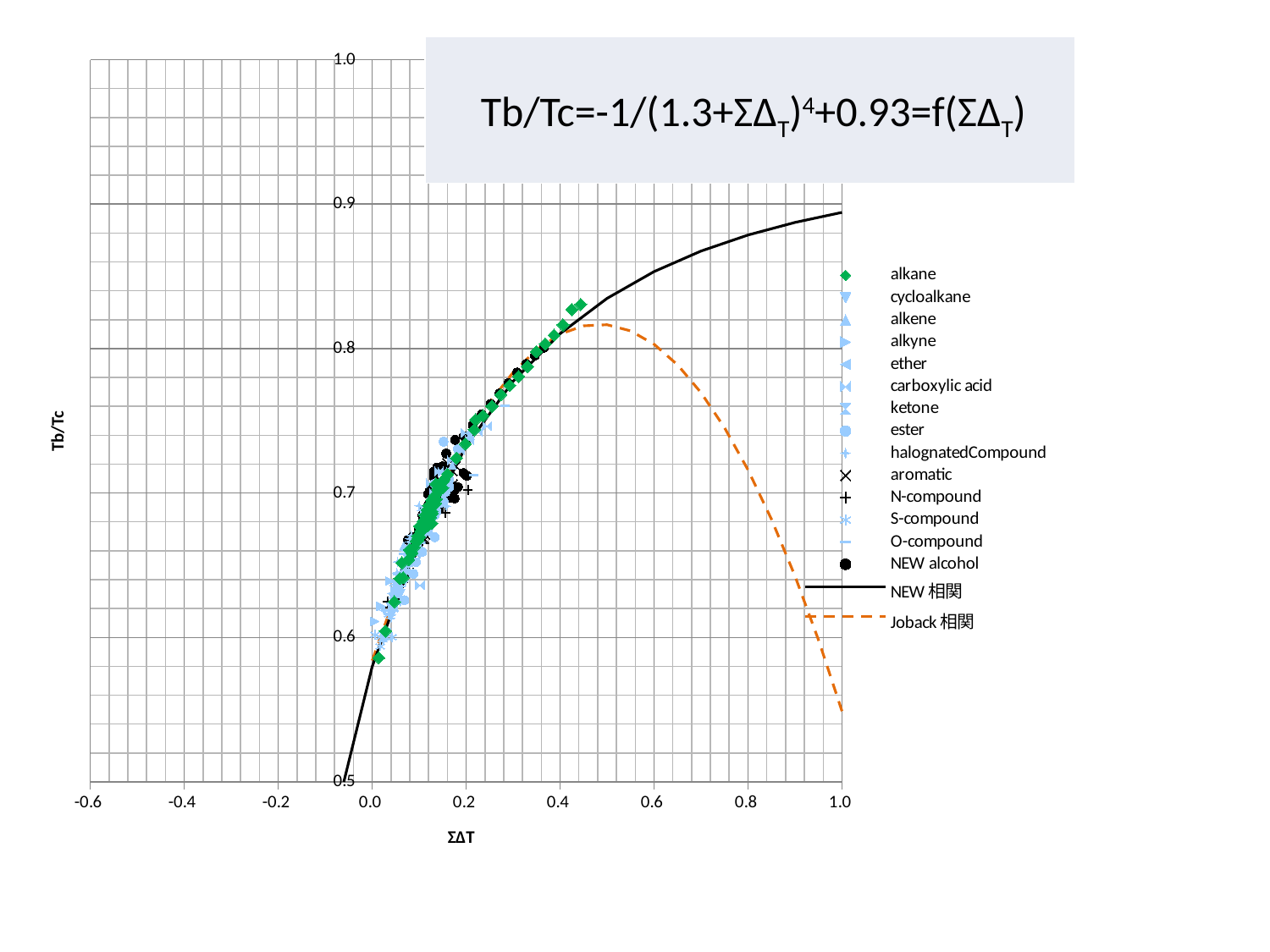
What kind of chart is shown on the slide? scatter chart Is the value of the Joback 相関 curve at ΣΔT = 1.0 greater or less than 0.6? less What is the title of the y axis of the chart? Tb/Tc Does the Joback 相関 curve rise or fall as ΣΔT increases from 0.6 to 1.0? fall Which legend entry is drawn as a dashed line? Joback 相関 Is the value of the NEW 相関 curve at ΣΔT = 1.0 greater or less than 0.9? less What is the title of the x axis of the chart? ΣΔT Is the peak value of the Joback 相関 curve greater or less than 0.8? greater Does the NEW 相関 curve rise or fall as ΣΔT increases from 0.0 to 1.0? rise How many entries does the chart's legend list? 16 At ΣΔT = 1.0, which curve has the higher Tb/Tc value, NEW 相関 or Joback 相関? NEW 相関